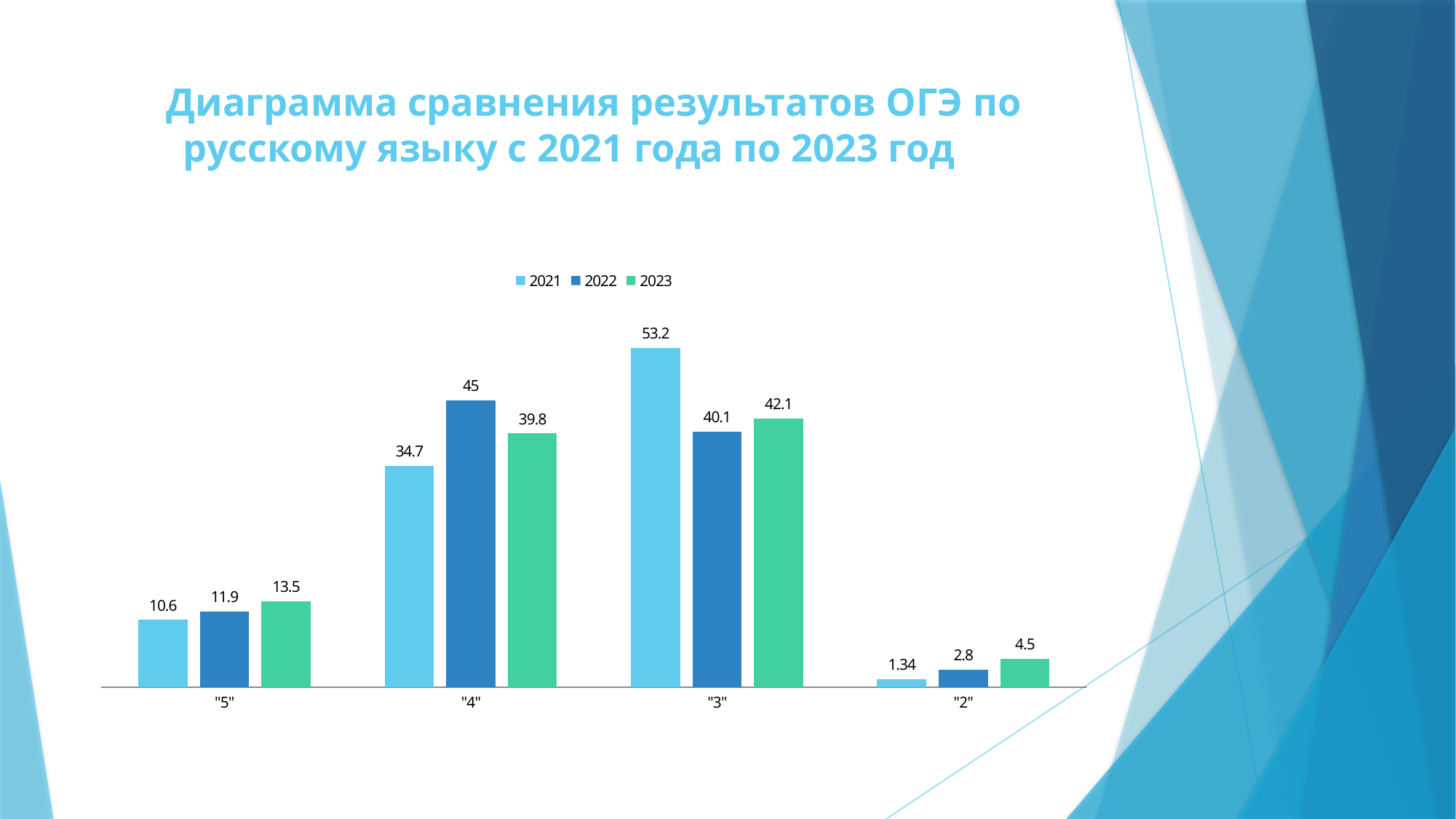
What is the value for grade "4" in 2022? 45 What is the value for grade "3" in 2023? 42.1 Which is larger for grade "4": the 2022 value or the 2023 value? 2022 Do the values for grade "2" rise or fall from 2021 to 2023? rise What is the difference between the 2021 and 2022 values for grade "3"? 13.1 Which grade category has the highest value in 2021? "3" What kind of chart is shown on the slide? bar chart How many series does the legend list? 3 How many grade categories are shown on the x axis? 4 What is the value for grade "5" in 2021? 10.6 Which grade category has the lowest value in 2023? "2" What is the value for grade "2" in 2021? 1.34